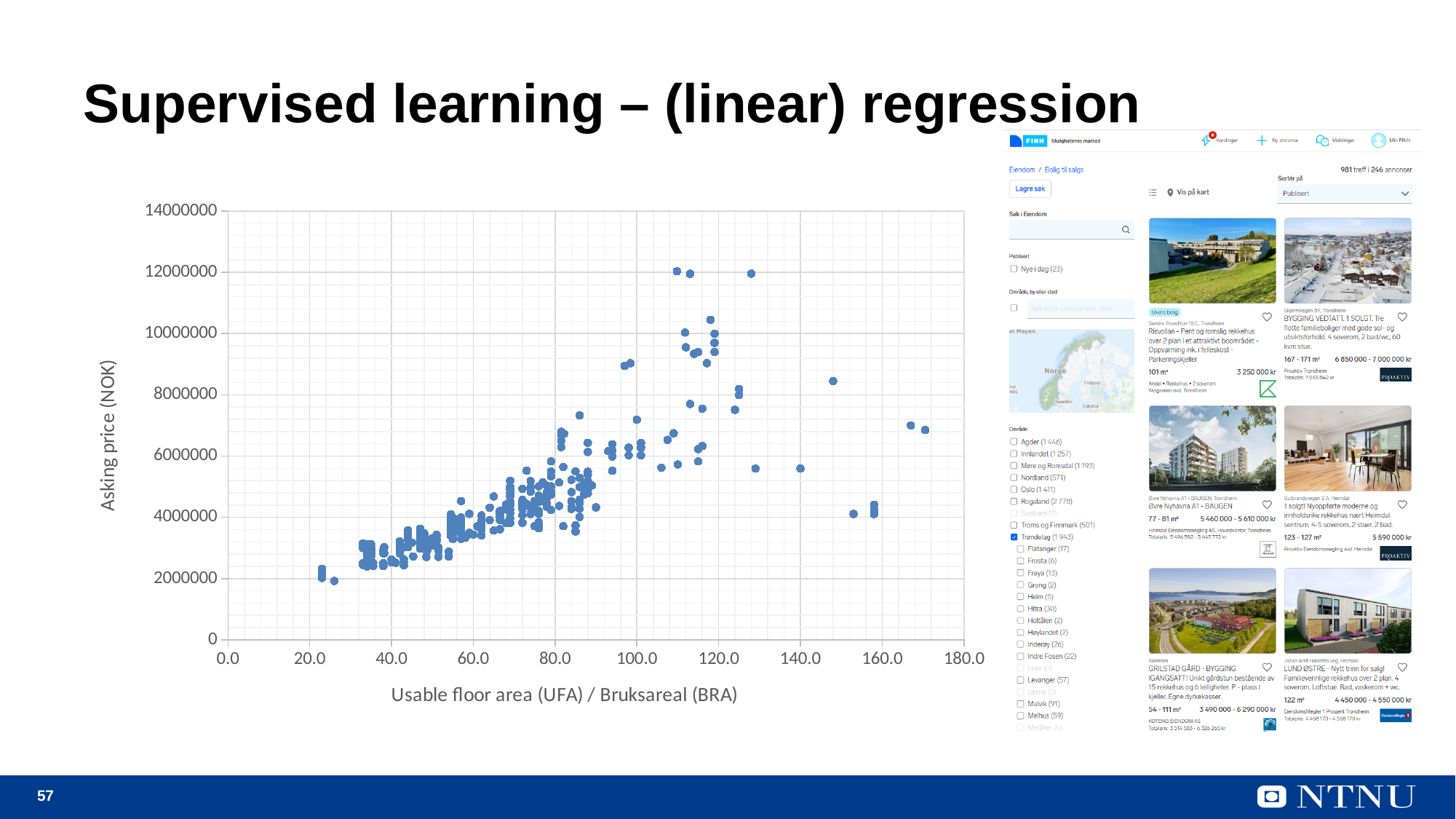
Is the asking price of the point with the largest usable floor area (around 170) greater or less than 6000000? greater What is the label of the x axis of the chart? Usable floor area (UFA) / Bruksareal (BRA) How many data series are plotted in the scatter chart? 1 Is the asking price of the point with the largest usable floor area (around 170) greater or less than 8000000? less What is the label of the y axis of the chart? Asking price (NOK) Do asking prices generally rise or fall as usable floor area increases along the x axis? rise What is the highest value shown on the y axis of the chart? 14000000 Is the highest asking price plotted in the chart greater or less than 10000000? greater What is the highest value shown on the x axis of the chart? 180.0 What kind of chart is shown on the slide? scatter plot What is the interval between consecutive tick marks on the x axis? 20.0